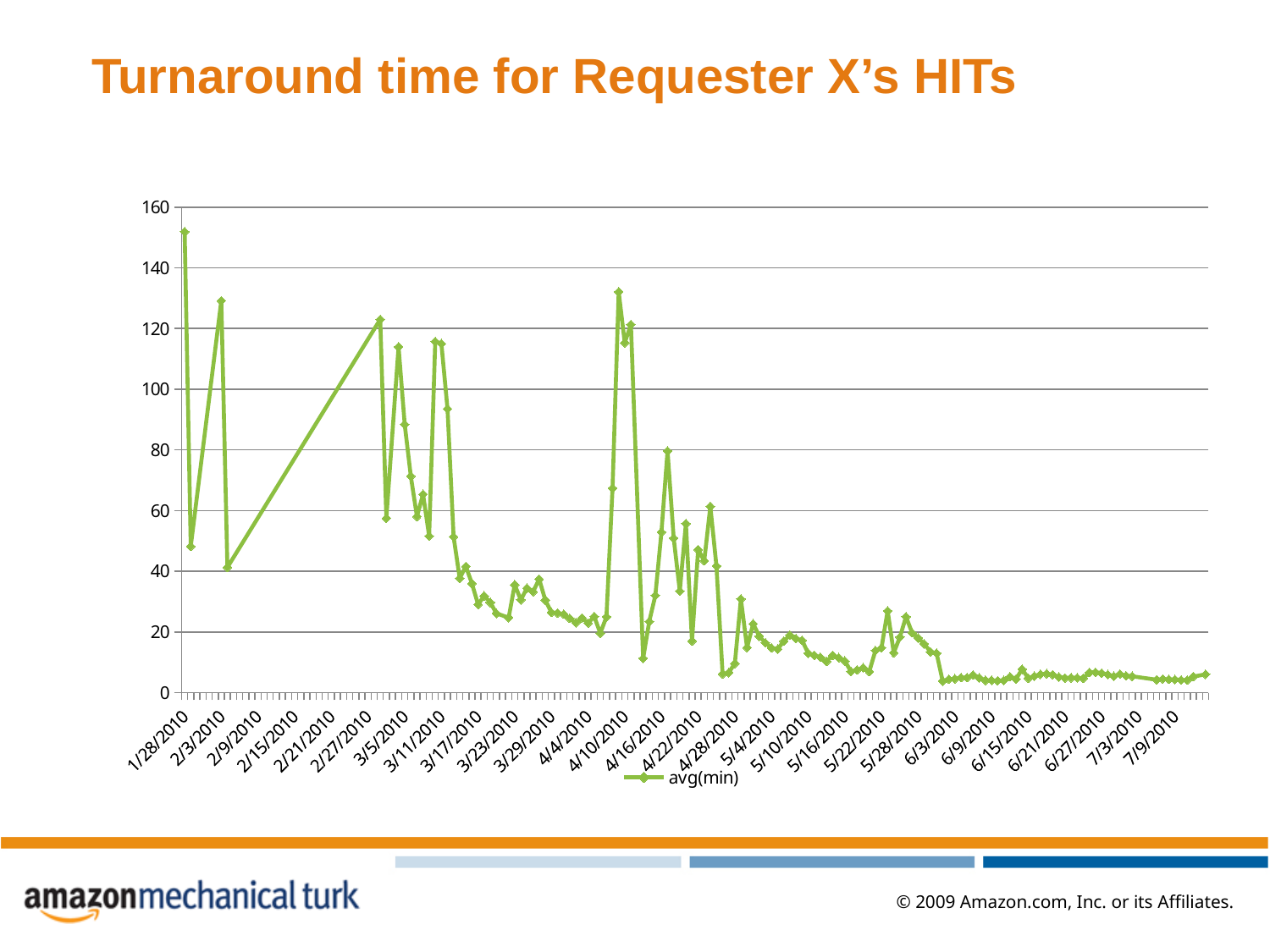
On which date does the line reach its highest value? 1/28/2010 What is the title of the chart? Turnaround time for Requester X's HITs What is the name of the series shown in the legend? avg(min) What kind of chart is shown on the slide? line chart Which is larger, the value for 1/28/2010 or the value for 7/9/2010? 1/28/2010 Is the value for 1/28/2010 greater or less than 140? greater Overall, do the values rise or fall from left to right along the x axis? fall Is the value for 6/9/2010 greater or less than 20? less Is the value for 7/9/2010 greater or less than 20? less How many series does the legend list? 1